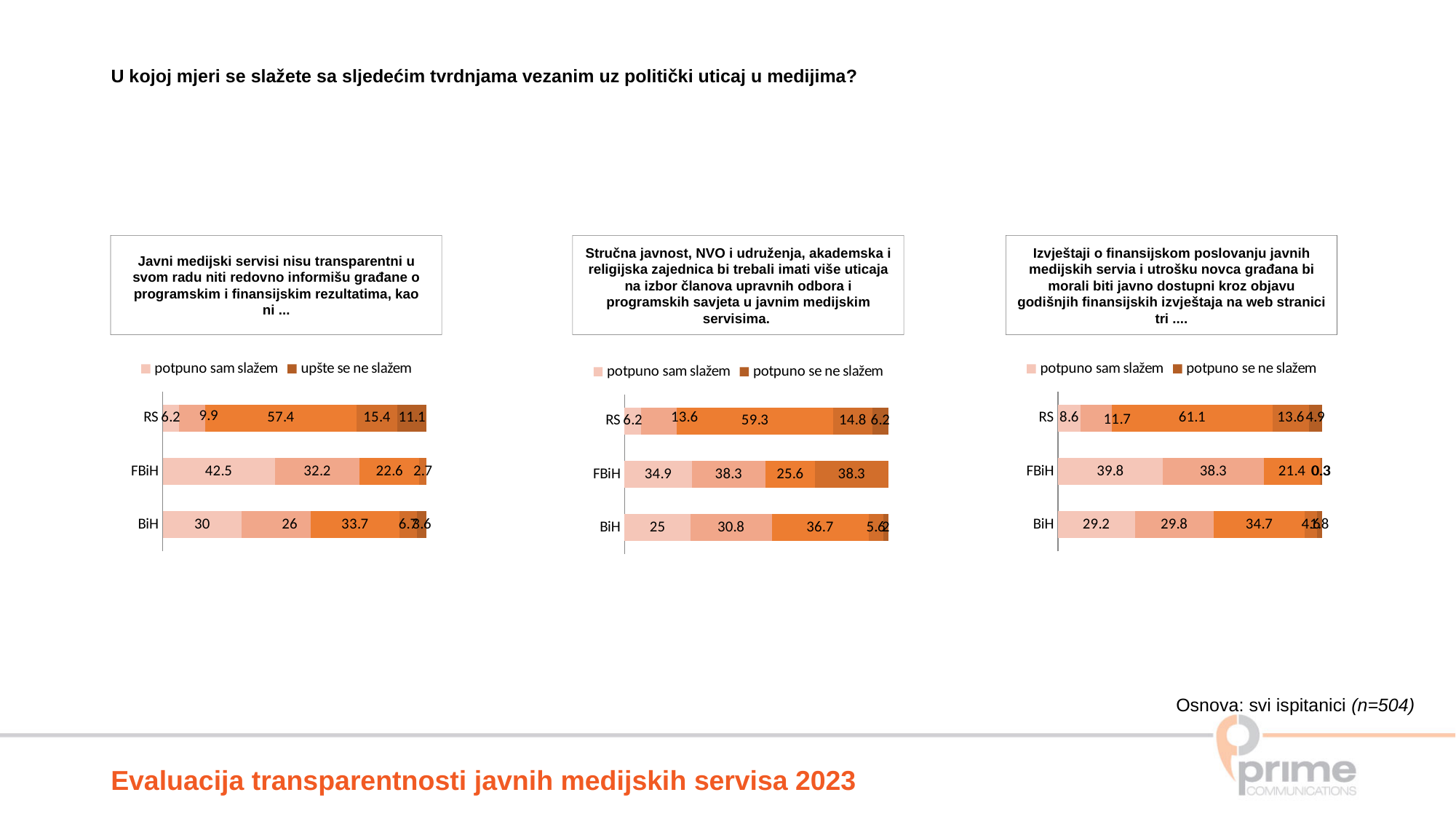
In the right chart ("Izvještaji o finansijskom poslovanju..."), what is the value of the largest segment in the RS bar? 61.1 How many categories (bars) does each chart on the slide show? 3 What is the second legend entry of the left chart? upšte se ne slažem In the middle chart ("Stručna javnost, NVO i udruženja..."), what is the value of the largest segment in the RS bar? 59.3 How many series does the legend of the middle chart list? 2 In the left chart ("Javni medijski servisi nisu transparentni..."), what is the value of the first (lightest) segment of the FBiH bar? 42.5 In the left chart ("Javni medijski servisi nisu transparentni..."), what is the value of the largest segment in the RS bar? 57.4 What type of chart is used for the three charts on the slide? Stacked bar chart In the middle chart ("Stručna javnost, NVO i udruženja..."), what is the value of the first (lightest) segment of the BiH bar? 25 In the right chart ("Izvještaji o finansijskom poslovanju..."), what is the value of the first (lightest) segment of the FBiH bar? 39.8 In the left chart, what is the difference between the first segment of the FBiH bar (42.5) and the first segment of the BiH bar (30)? 12.5 In the right chart, which is larger: the first segment of the FBiH bar or the first segment of the BiH bar? FBiH